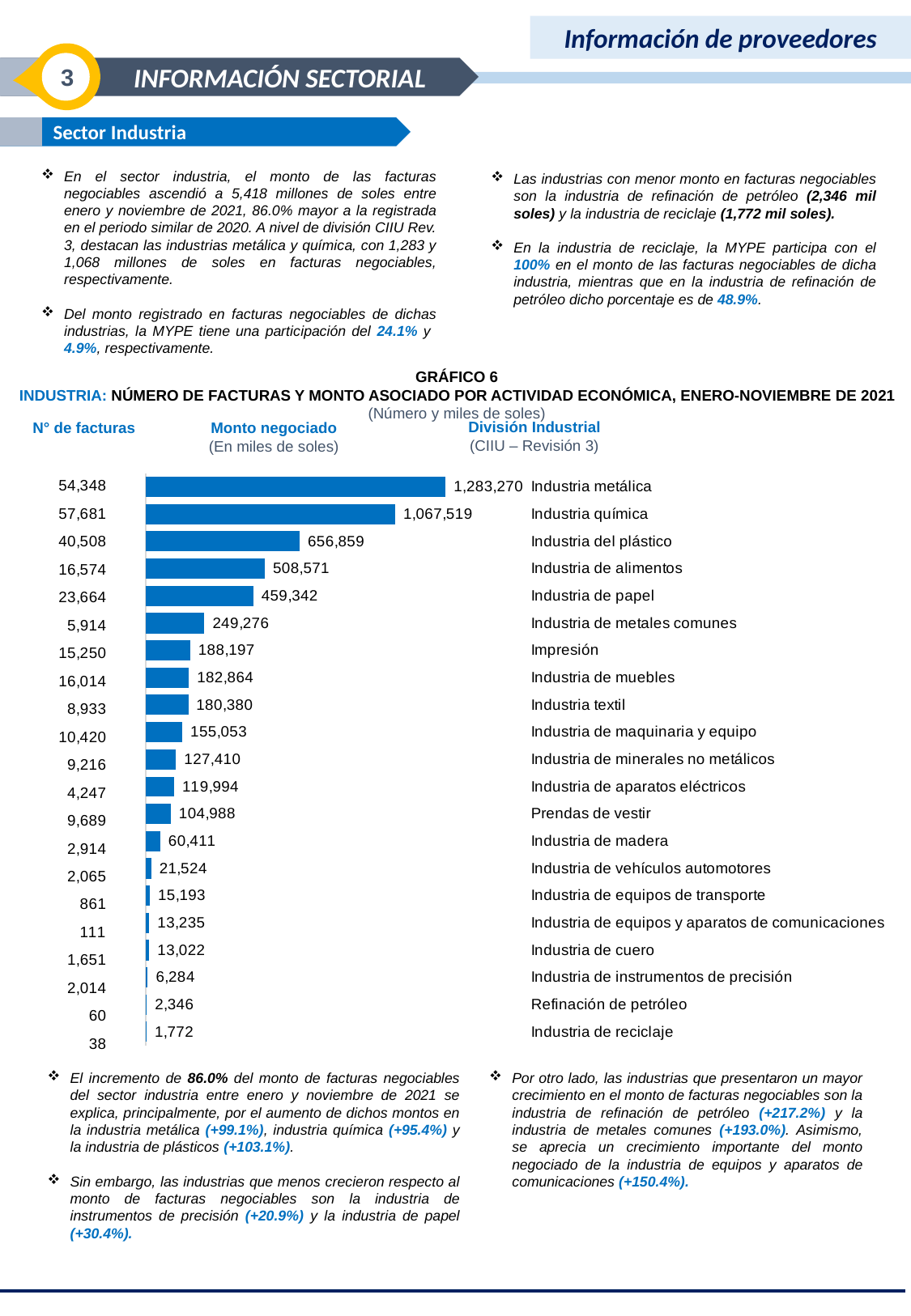
What type of chart is shown in Gráfico 6? bar chart What is the monto negociado (en miles de soles) for Industria química? 1,067,519 Which has a larger monto negociado, Industria de alimentos or Industria de papel? Industria de alimentos In what unit is the monto negociado expressed in the chart? En miles de soles How many industrial divisions are shown in the chart? 21 Do the monto negociado values increase or decrease going from the top of the chart to the bottom? decrease What is the N° de facturas for Industria del plástico? 40,508 What is the difference in monto negociado between Industria metálica and Industria química? 215,751 What is the monto negociado (en miles de soles) for Industria de papel? 459,342 Which industrial division has the lowest monto negociado? Industria de reciclaje Which industrial division has the highest N° de facturas? Industria química Which industrial division has the highest monto negociado? Industria metálica